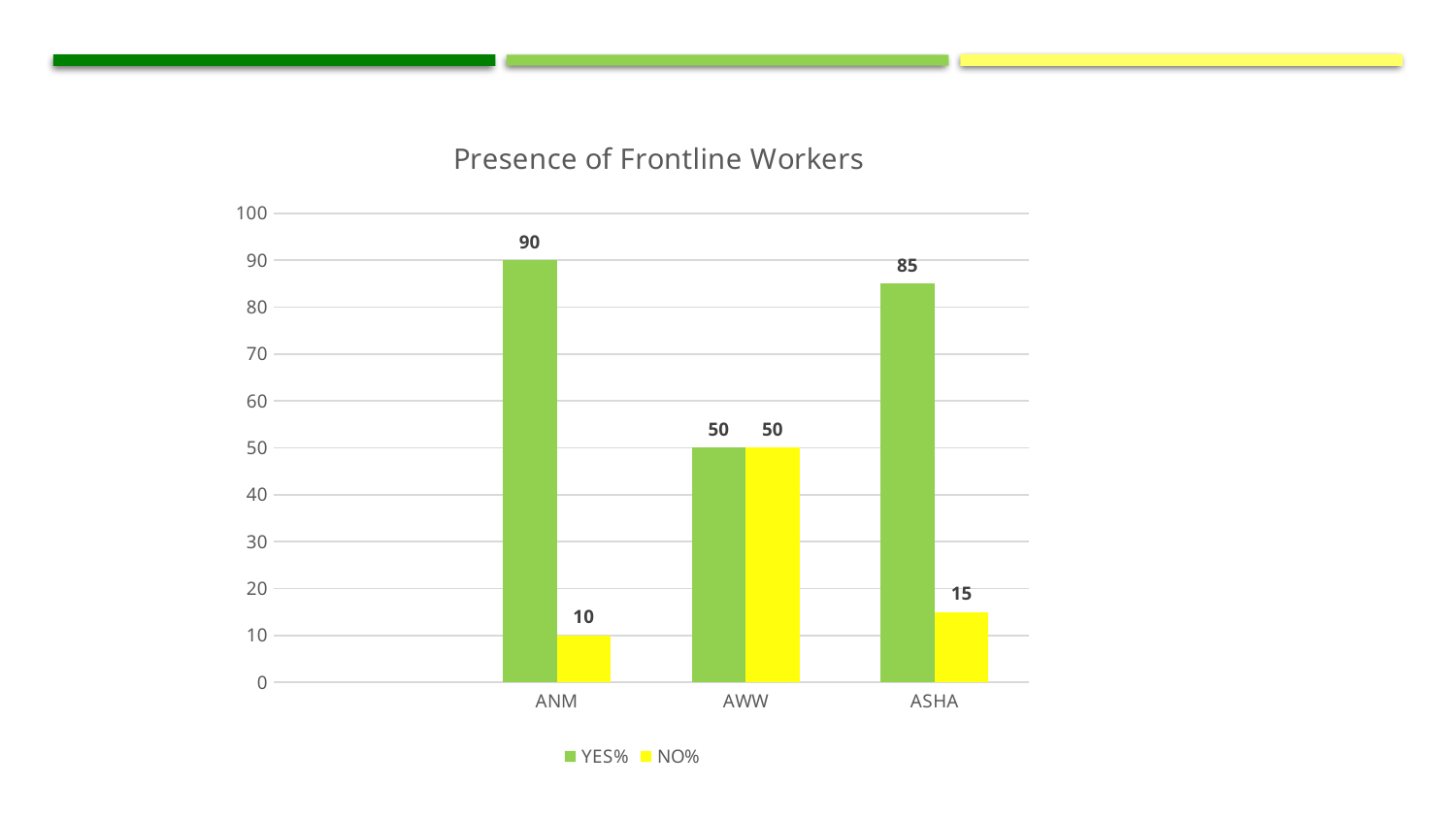
What is the NO% value for ASHA? 15 Which category has the highest YES% value? ANM What is the YES% value for ANM? 90 What kind of chart is shown on the slide? Bar chart How many series does the legend list? 2 Which is larger, the NO% value for ASHA or the NO% value for ANM? ASHA What is the NO% value for AWW? 50 What is the title of the chart? Presence of Frontline Workers Which category has the lowest NO% value? ANM What colour represents the NO% series? Yellow What is the difference between the YES% values for ANM and ASHA? 5 How many categories are shown on the x axis? 3